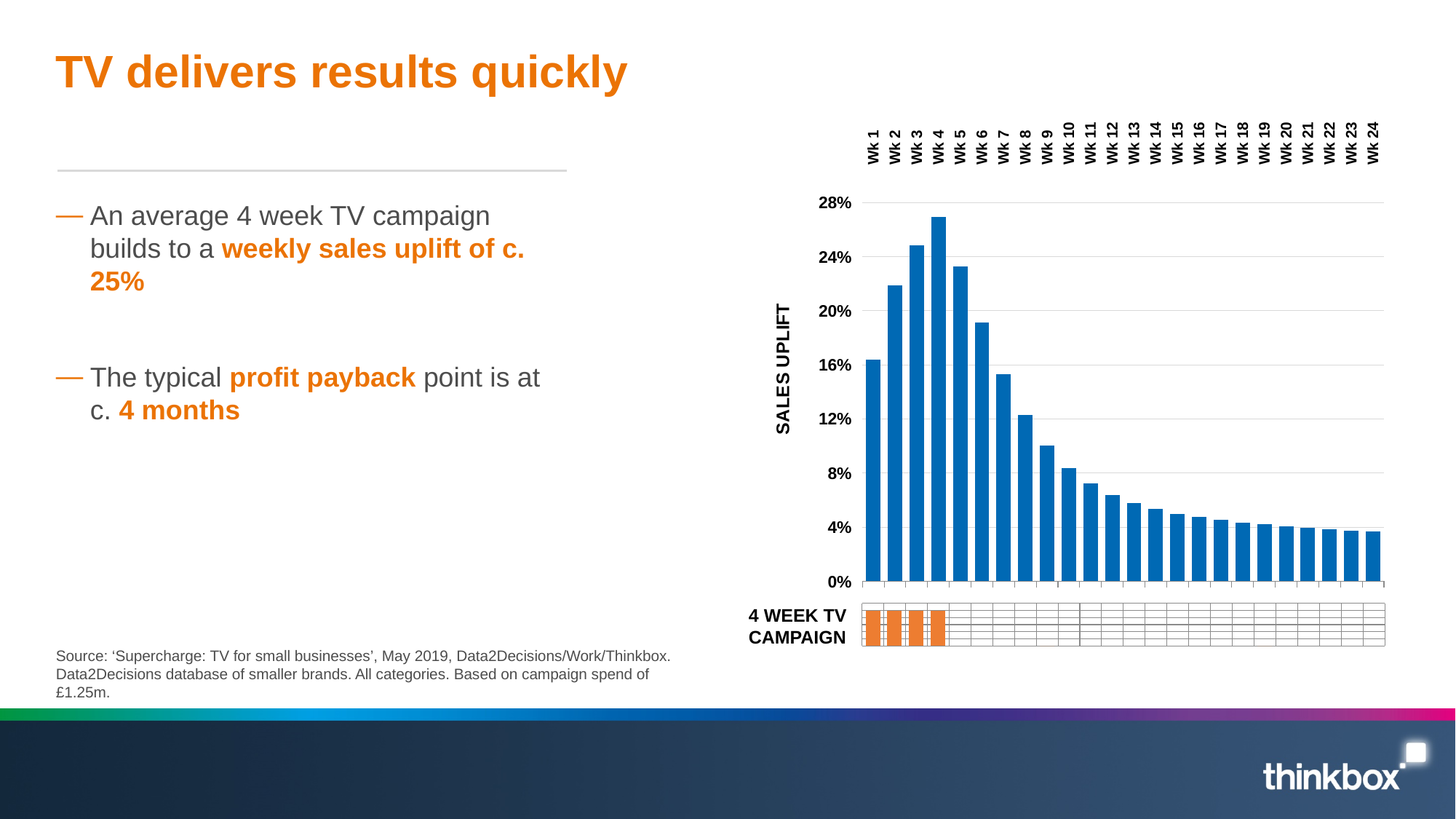
What is the label on the vertical axis of the chart? SALES UPLIFT How many weeks are plotted on the chart? 24 Which week has the highest sales uplift? Wk 4 Is the sales uplift for Wk 4 greater or less than 24%? greater Which has the higher sales uplift, Wk 3 or Wk 5? Wk 3 What kind of chart is shown on the slide? bar chart Which week has the lowest sales uplift? Wk 24 Do the sales uplift values rise or fall from Wk 4 to Wk 24? fall Is the sales uplift for Wk 11 greater or less than 8%? less Is the sales uplift for Wk 6 greater or less than 20%? less